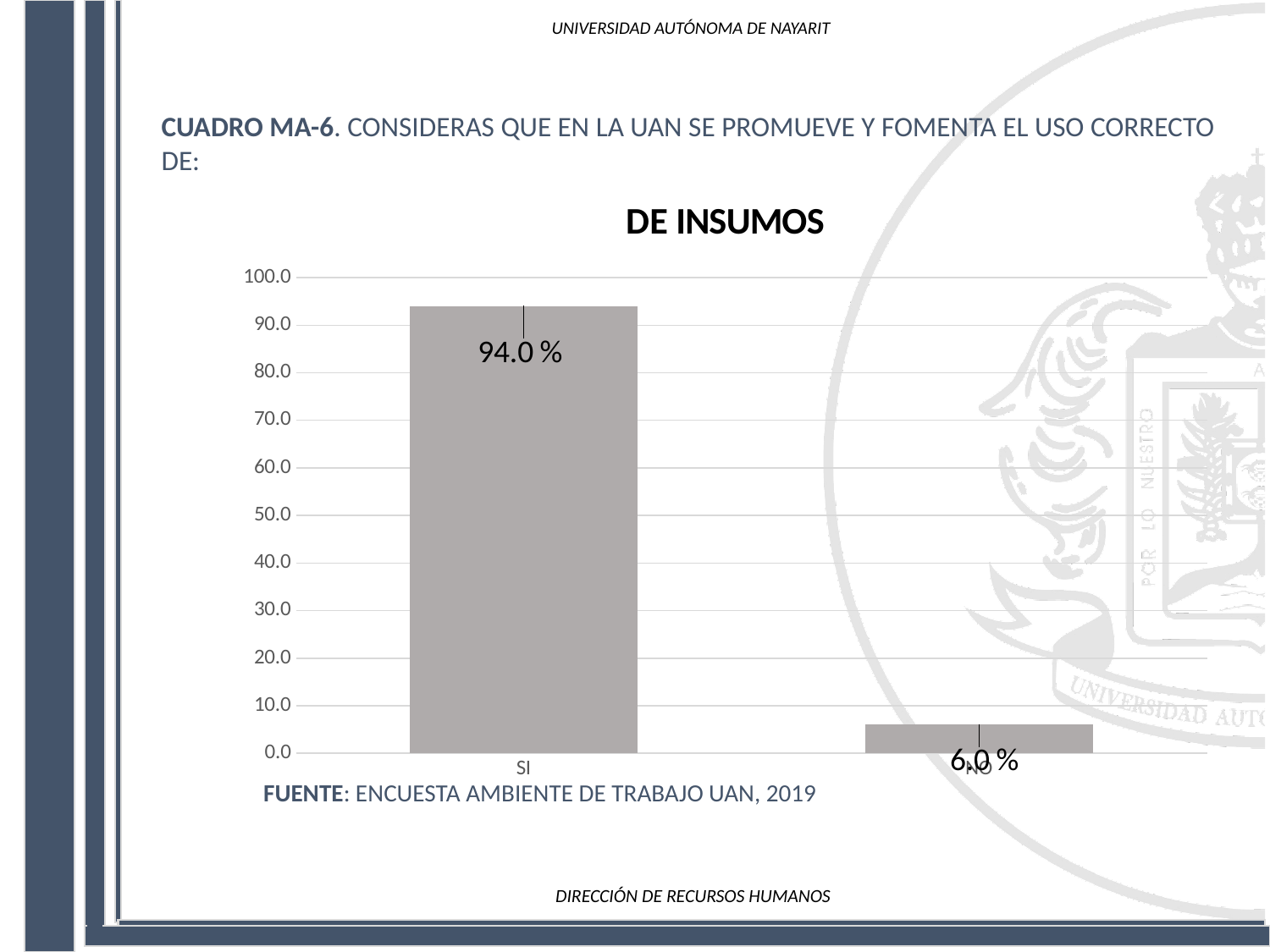
What kind of chart is shown on the slide? Bar chart Is the value for NO in the DE INSUMOS chart greater or less than 10.0? less Which is larger in the DE INSUMOS chart, the value for SI or the value for NO? SI What is the difference between the SI and NO values in the DE INSUMOS chart? 88.0 % Which category has the highest value in the DE INSUMOS chart? SI What is the value shown for the NO category (the second bar) in the DE INSUMOS chart? 6.0 % What is the highest value shown on the vertical axis of the DE INSUMOS chart? 100.0 How many categories are shown in the DE INSUMOS chart? 2 What is the value shown for the SI category in the DE INSUMOS chart? 94.0 % Which category has the lowest value in the DE INSUMOS chart? NO What is the title of the chart on the slide? DE INSUMOS Is the value for SI in the DE INSUMOS chart greater or less than 90.0? greater